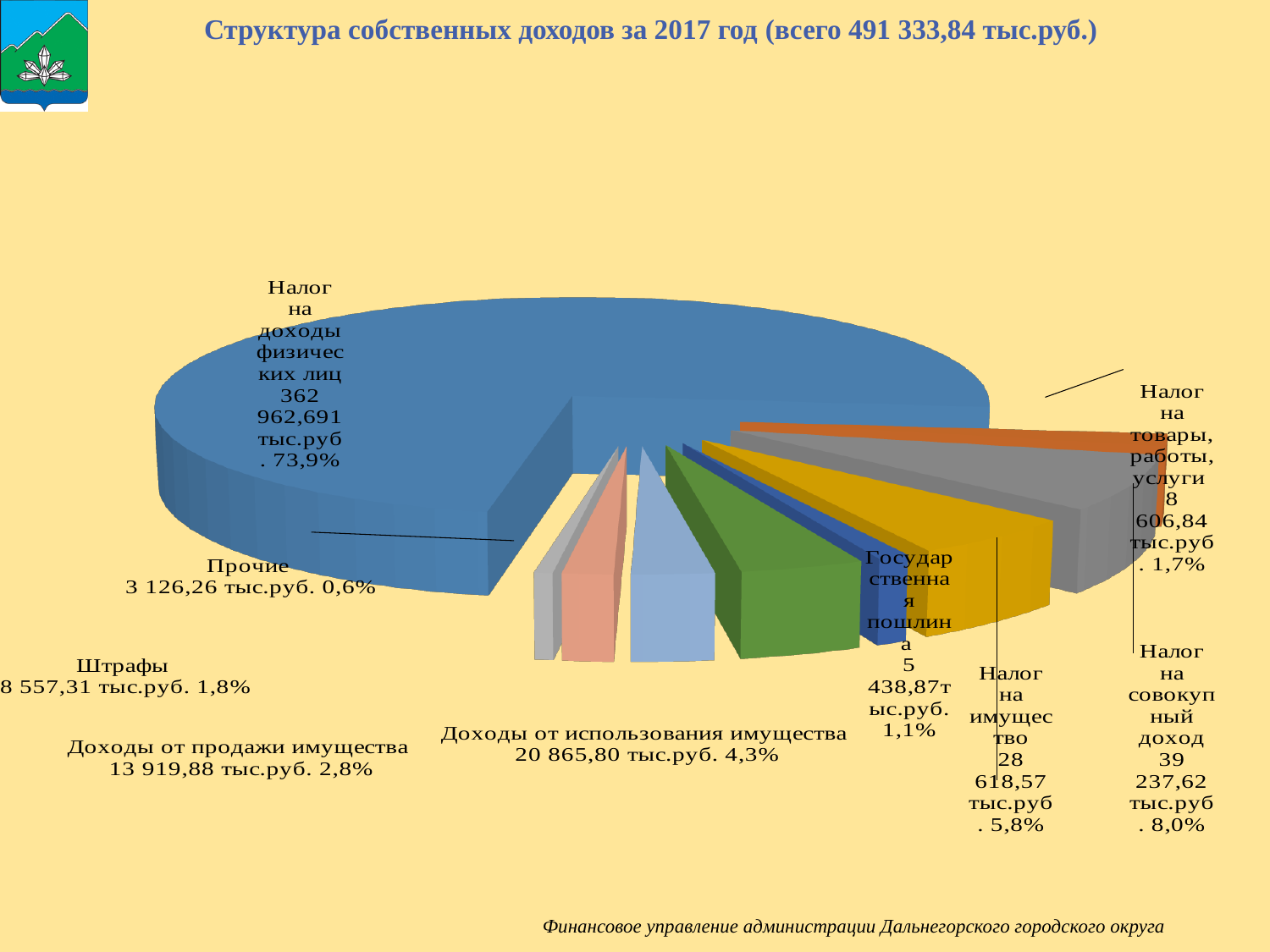
Which category has the largest share of the pie? Налог на доходы физических лиц What is the value shown for 'Налог на совокупный доход'? 39 237,62 тыс.руб. What is the value shown for 'Доходы от использования имущества'? 20 865,80 тыс.руб. Which category has the smallest share of the pie? Прочие What is the difference in percentage points between 'Налог на совокупный доход' and 'Налог на имущество'? 2,2% What is the value shown for 'Государственная пошлина'? 5 438,87 тыс.руб. What total amount is stated in the chart title? 491 333,84 тыс.руб. What share of the pie does 'Налог на доходы физических лиц' represent? 73,9% What kind of chart is shown on the slide? pie chart How many slices does the pie chart have? 9 What percentage is shown for 'Налог на имущество'? 5,8%